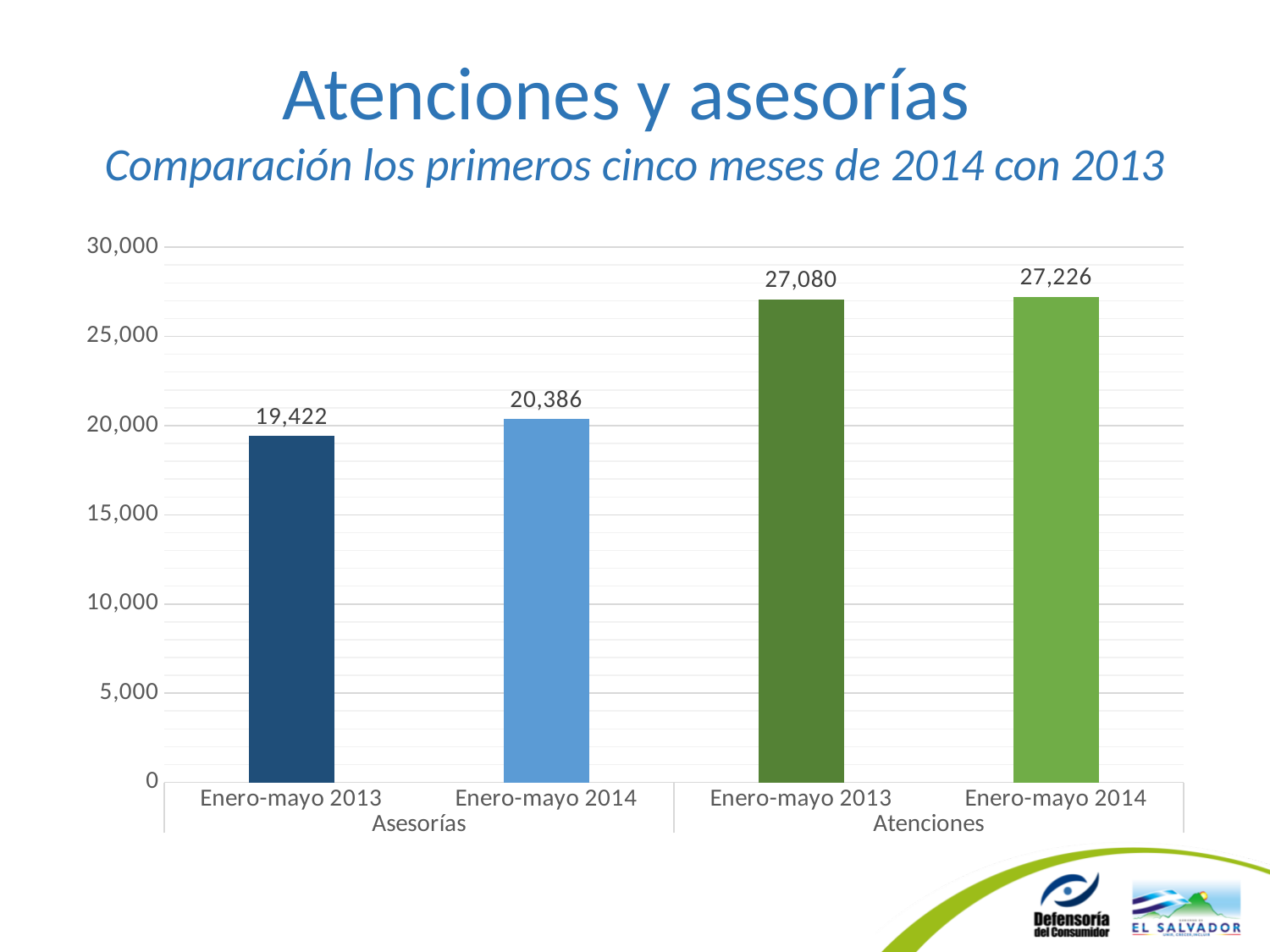
Which bar has the highest value? Atenciones, Enero-mayo 2014 What is the value for Atenciones in Enero-mayo 2013? 27,080 What kind of chart is shown on the slide? bar chart What is the value for Asesorías in Enero-mayo 2014? 20,386 Which is larger: Atenciones in Enero-mayo 2013 or Asesorías in Enero-mayo 2014? Atenciones in Enero-mayo 2013 What is the value for Atenciones in Enero-mayo 2014? 27,226 What is the difference between Asesorías in Enero-mayo 2014 and Enero-mayo 2013? 964 How many bars are plotted in the chart? 4 What is the value for Asesorías in Enero-mayo 2013? 19,422 Is the value for Asesorías in Enero-mayo 2013 greater or less than 20,000? less Which bar has the lowest value? Asesorías, Enero-mayo 2013 What is the difference between Atenciones in Enero-mayo 2014 and Enero-mayo 2013? 146